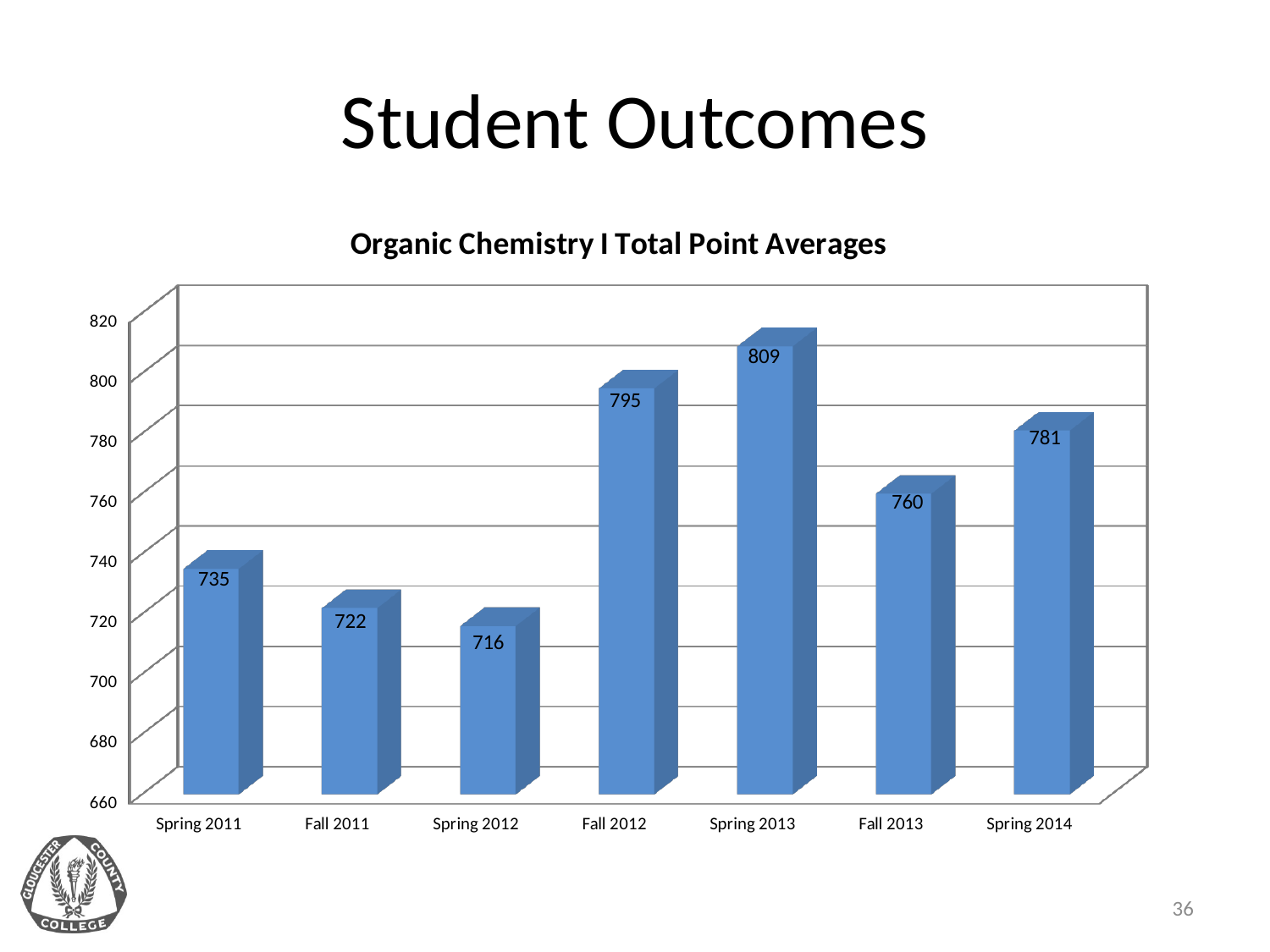
Which semester has the highest total point average? Spring 2013 What is the title of the chart? Organic Chemistry I Total Point Averages What kind of chart is shown on the slide? Bar chart What is the difference between the total point averages for Spring 2013 and Spring 2012? 93 Which semester has the lowest total point average? Spring 2012 How many semesters are shown on the chart? 7 Which has a higher total point average, Spring 2011 or Fall 2013? Fall 2013 What is the total point average for Spring 2014? 781 Is the value for Fall 2012 greater or less than 780? greater What is the difference between the total point averages for Fall 2012 and Fall 2013? 35 What is the total point average for Spring 2013? 809 What is the total point average for Fall 2011? 722